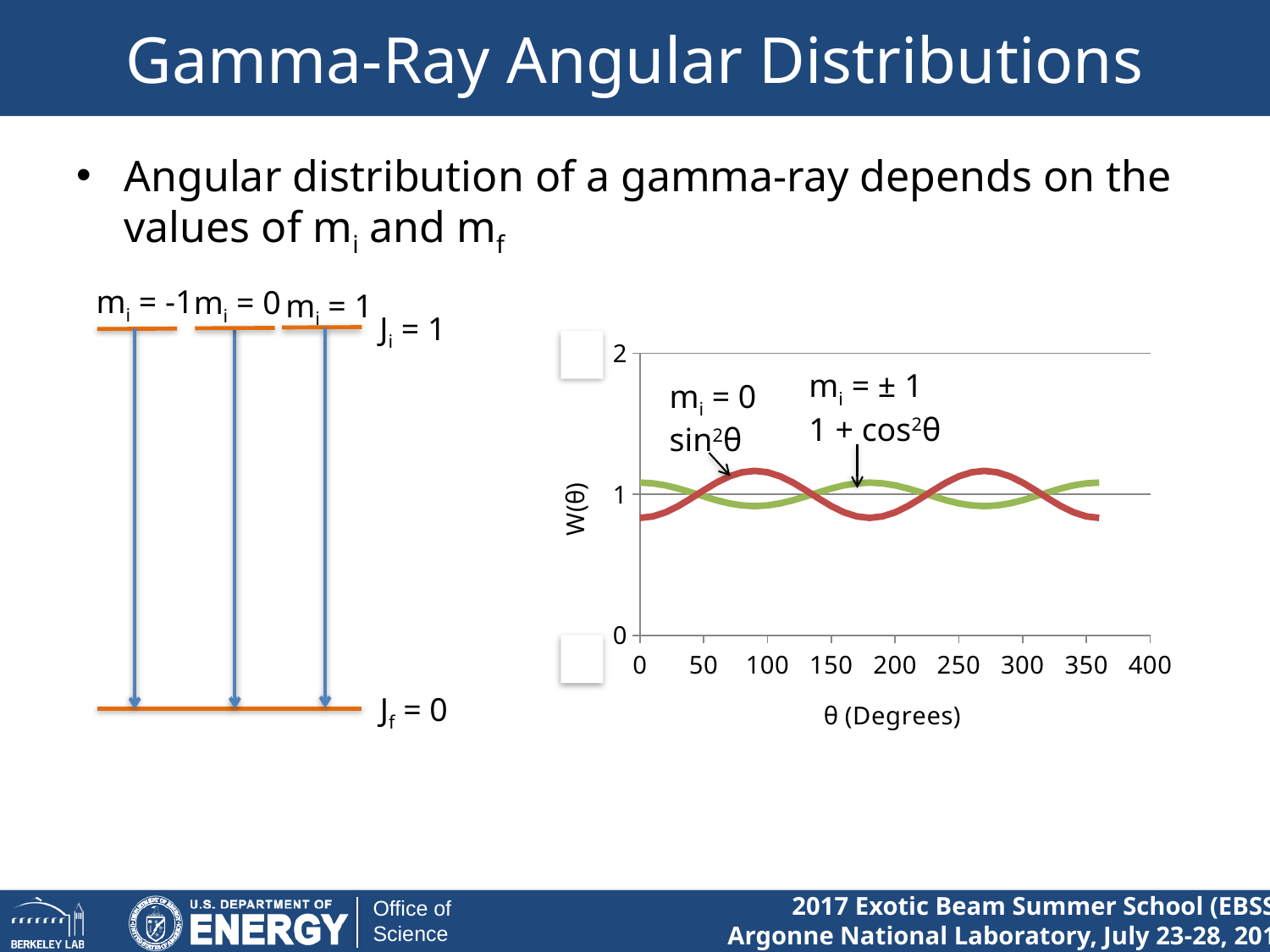
Is the value of the m_i = ± 1 (1 + cos²θ) curve at θ = 0 degrees greater or less than 1? greater Which function is labelled for the m_i = ± 1 curve? 1 + cos²θ At θ = 180 degrees, which curve has the higher W(θ) value, m_i = 0 or m_i = ± 1? m_i = ± 1 What kind of chart is shown on the slide? line chart What is the label of the y axis of the chart? W(θ) Which function is labelled for the m_i = 0 curve? sin²θ At θ = 90 degrees, which curve has the higher W(θ) value, m_i = 0 or m_i = ± 1? m_i = 0 Is the value of the m_i = 0 (sin²θ) curve at θ = 90 degrees greater or less than 1? greater What is the label of the x axis of the chart? θ (Degrees) What is the highest value shown on the y axis of the chart? 2 How many curves are plotted on the chart? 2 Is the value of the m_i = ± 1 (1 + cos²θ) curve at θ = 90 degrees greater or less than 1? less